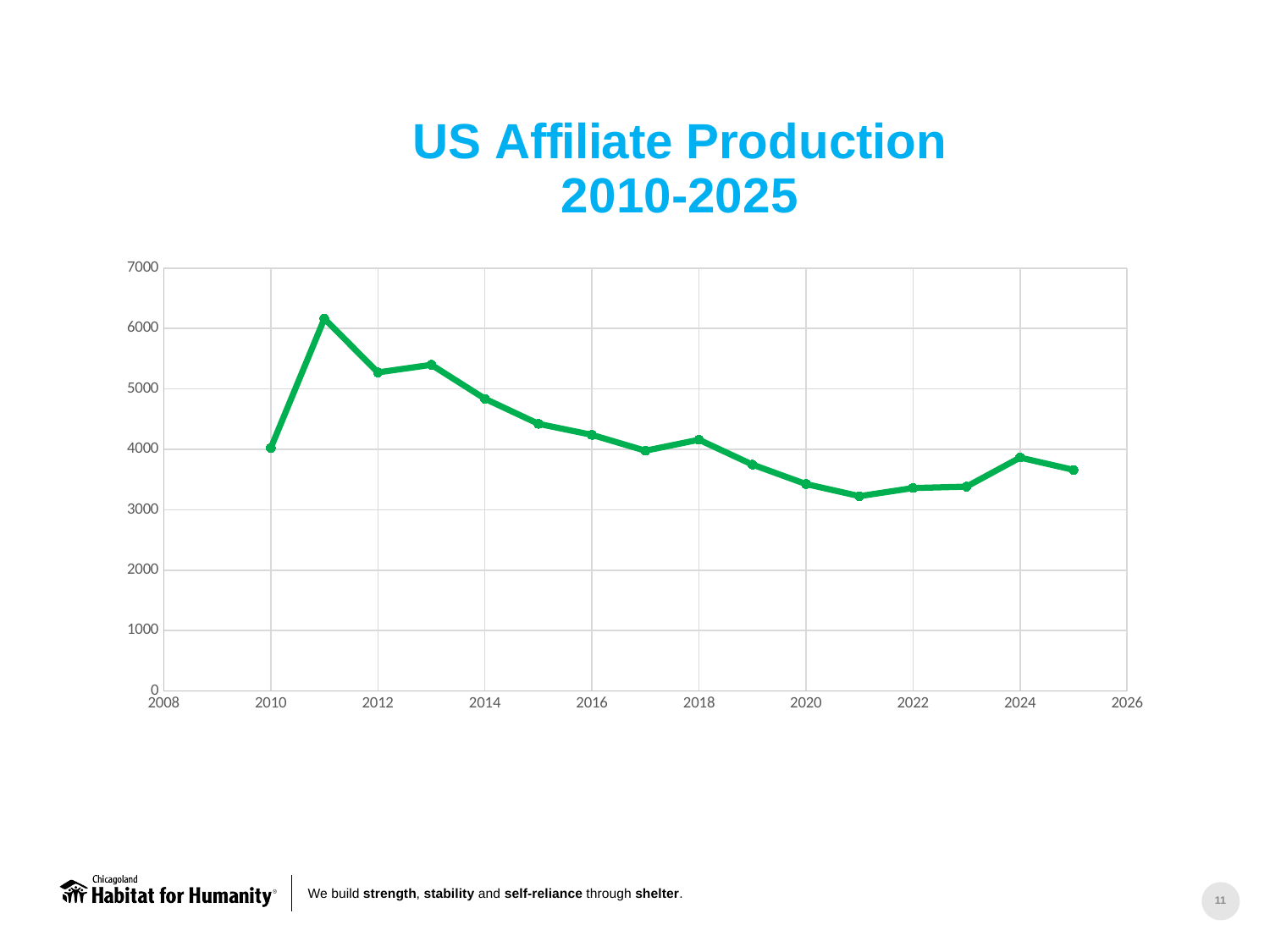
Do the values generally rise or fall from 2011 to 2021? fall Which year has the lowest value? 2021 Is the value for 2021 greater or less than 4000? less How many data points are plotted on the line? 16 What kind of chart is shown on the slide? line chart Is the value for 2014 greater or less than 4000? greater Which is larger, the value for 2018 or the value for 2020? 2018 What is the title of the chart? US Affiliate Production 2010-2025 Is the value for 2011 greater or less than 6000? greater Which year has the highest value? 2011 Which is larger, the value for 2012 or the value for 2016? 2012